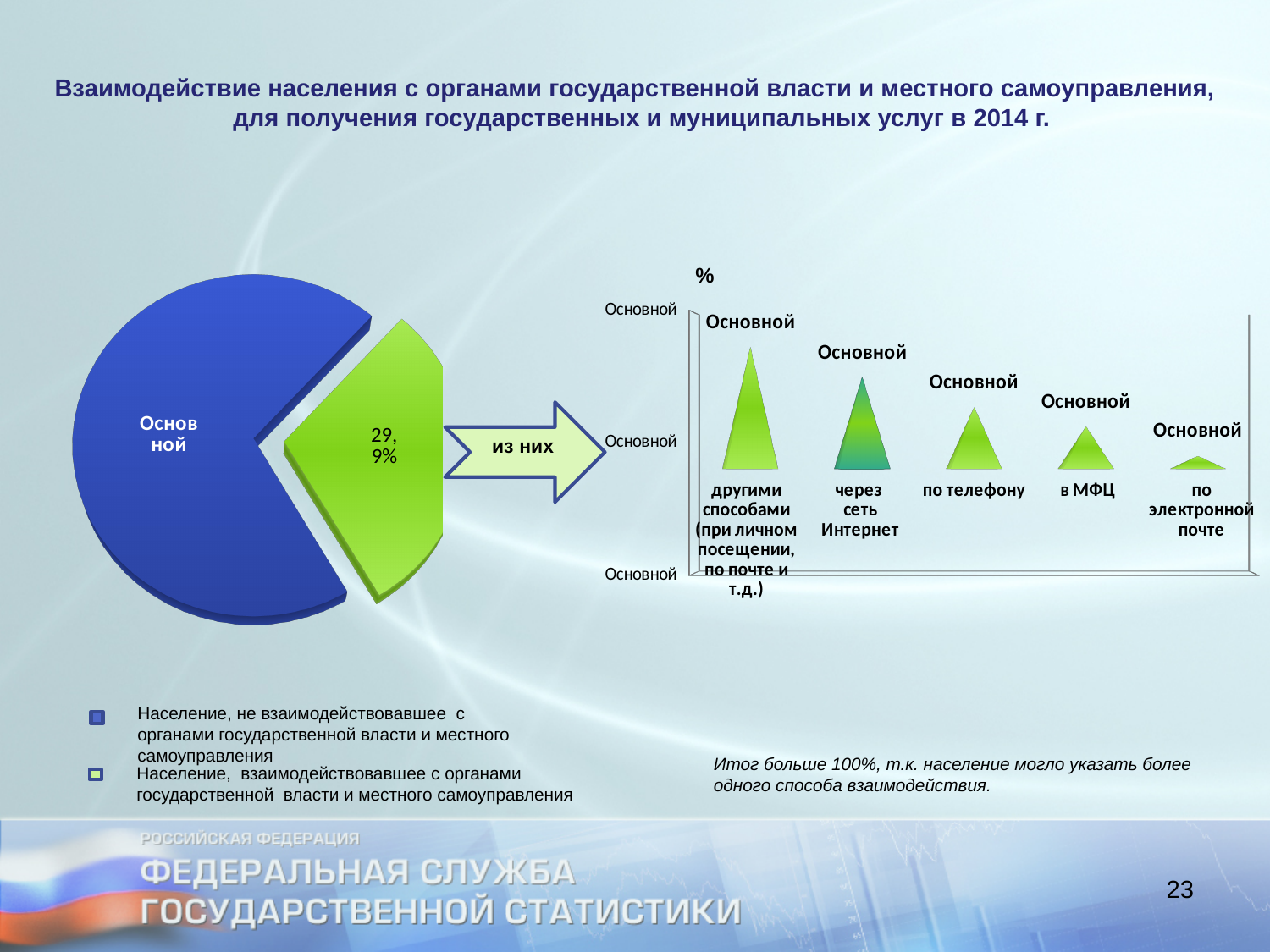
In the bar chart on the right, which category has the lowest value? по электронной почте In the pie chart on the left, what value is printed on the green slice? 29,9% According to the legend, what does the green colour in the pie chart represent? Население, взаимодействовавшее с органами государственной власти и местного самоуправления How many slices does the pie chart on the left have? 2 In the bar chart on the right, which is larger, the value for через сеть Интернет or the value for в МФЦ? через сеть Интернет According to the legend, what does the blue colour in the pie chart represent? Население, не взаимодействовавшее с органами государственной власти и местного самоуправления In the pie chart on the left, what share of the pie does the green slice (population that interacted with government bodies) represent? 29,9% In the bar chart on the right, do the values rise or fall from left to right? fall What kind of chart is the chart on the right of the slide? bar chart In the pie chart on the left, which slice is larger, the blue one or the green one? the blue one How many categories are shown in the bar chart on the right? 5 In the bar chart on the right, which category has the highest value? другими способами (при личном посещении, по почте и т.д.)